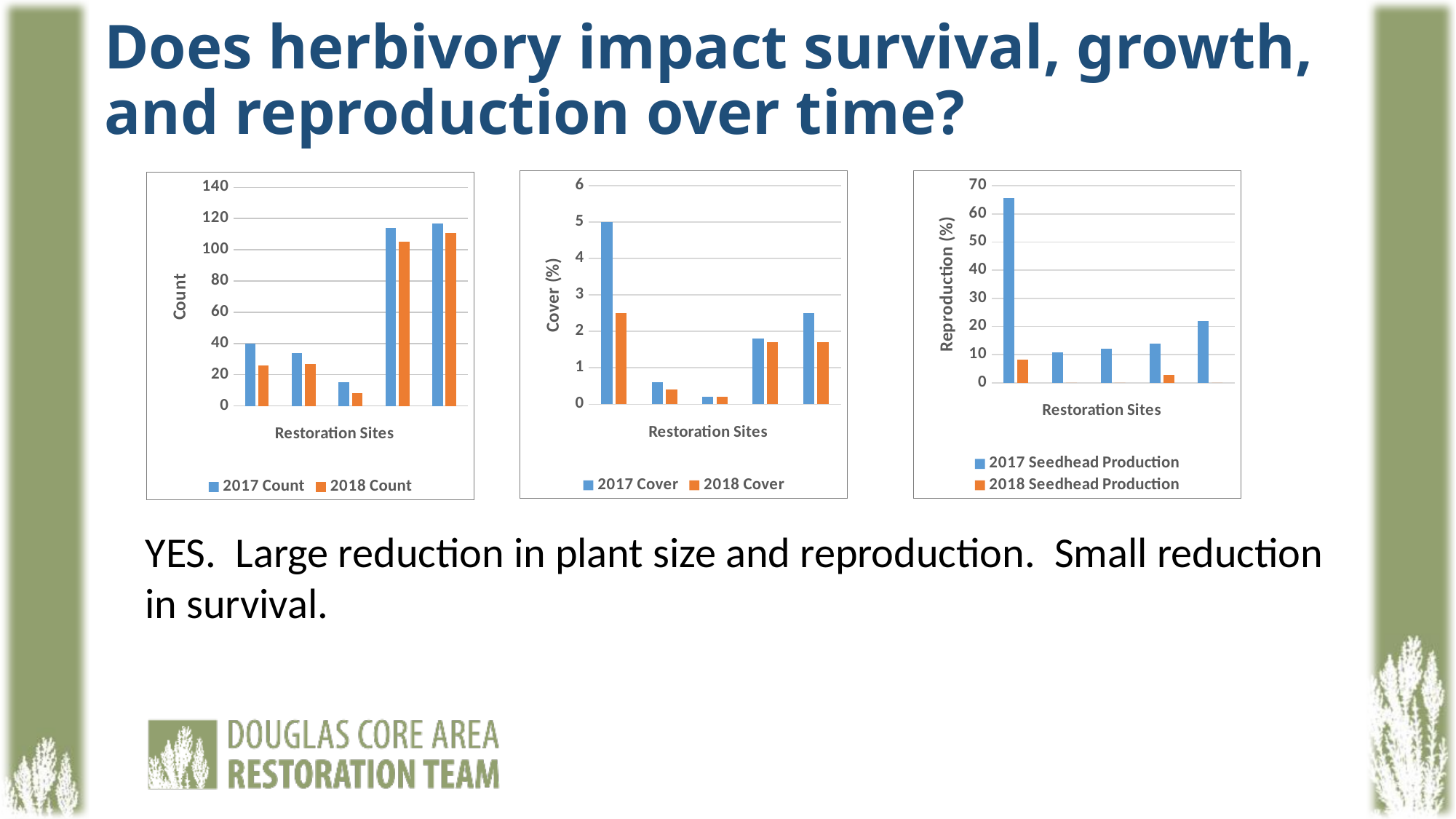
What is the y-axis label of the right chart? Reproduction (%) In the left chart (Count), how many series does the legend list? 2 In the middle chart (Cover), is the 2018 Cover value for the leftmost site greater or less than 2? greater In the left chart (Count), how many groups of bars (restoration sites) are plotted? 5 What kind of chart is the left chart with the Count axis? bar chart In the middle chart (Cover), is the 2017 Cover value for the leftmost site greater or less than 4? greater In the right chart (Reproduction), how many series does the legend list? 2 In the left chart (Count), is the 2017 Count value for the leftmost site greater or less than 60? less In the left chart (Count), what are the two legend entries? 2017 Count and 2018 Count In the middle chart (Cover), which site has the highest 2017 Cover value? the leftmost site In the right chart (Reproduction), which series has the larger value for the leftmost site, 2017 Seedhead Production or 2018 Seedhead Production? 2017 Seedhead Production